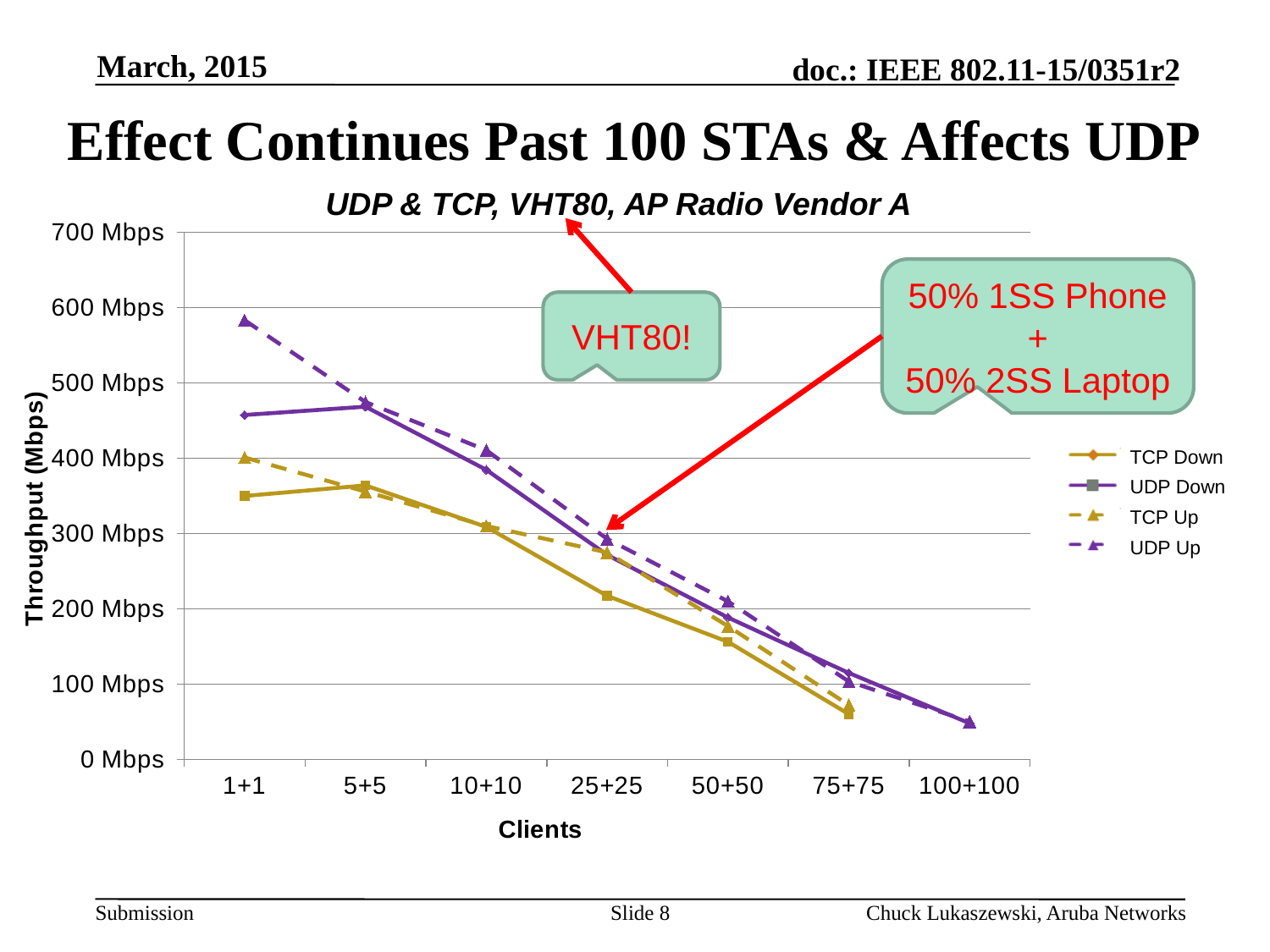
Is the value for UDP Up at 1+1 clients greater or less than 500 Mbps? greater Is the value for TCP Down at 75+75 clients greater or less than 100 Mbps? less Do the throughput values generally rise or fall as the number of clients increases? fall What kind of chart is shown on the slide? line chart What is the label of the y axis? Throughput (Mbps) At 1+1 clients, which is larger: UDP Up or TCP Down? UDP Up What is the title of the chart? UDP & TCP, VHT80, AP Radio Vendor A Is the value for UDP Down at 100+100 clients greater or less than 100 Mbps? less Which series has the highest throughput at 1+1 clients? UDP Up How many client configurations are shown along the x axis? 7 How many series does the legend list? 4